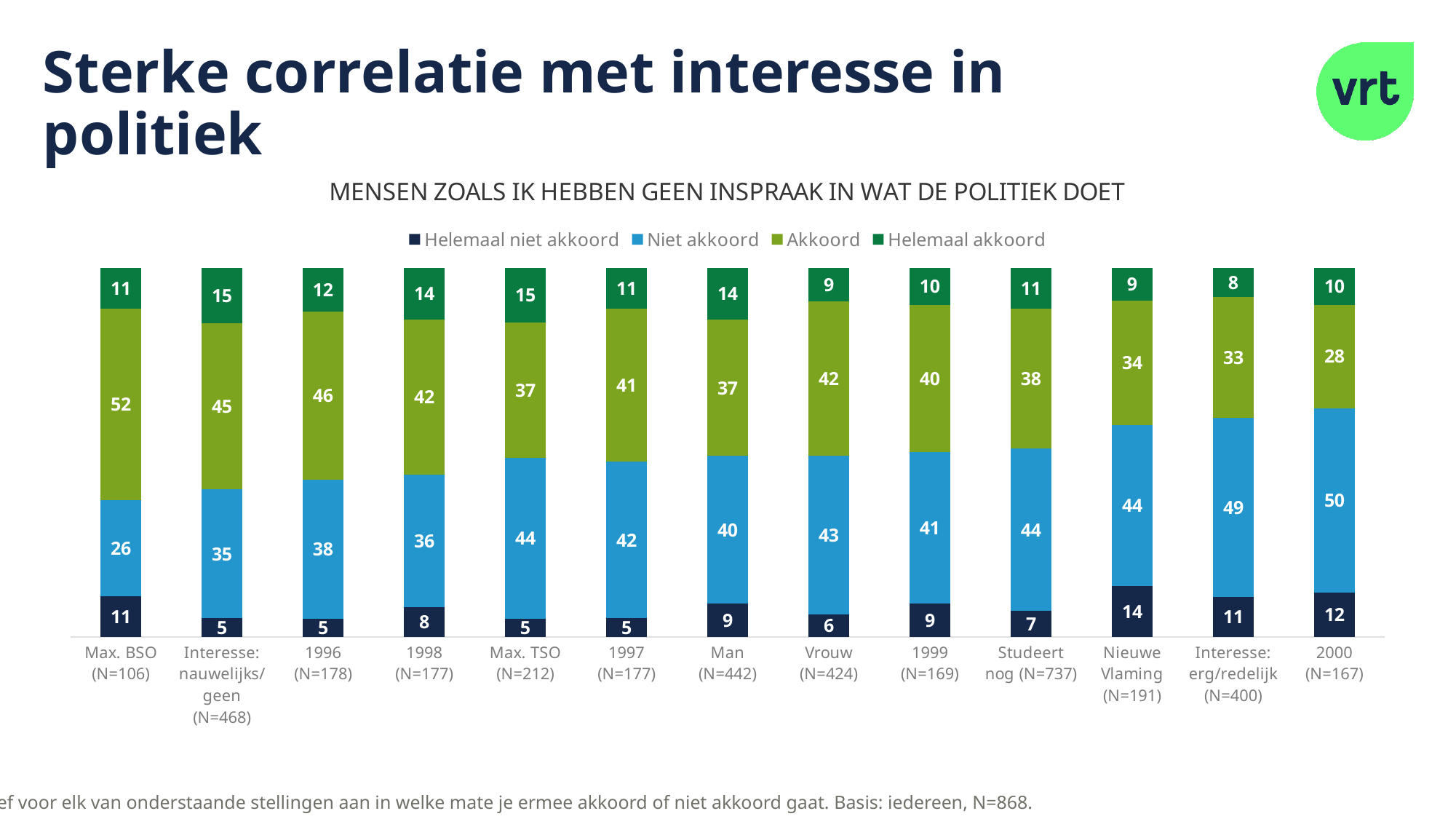
What is the difference between the 'Niet akkoord' values for Interesse: erg/redelijk (N=400) and Interesse: nauwelijks/geen (N=468)? 14 Which is larger: the 'Helemaal akkoord' value for Max. TSO (N=212) or for Vrouw (N=424)? Max. TSO (N=212) What is the total of the stacked bar for Man (N=442)? 100 What is the 'Niet akkoord' value for 2000 (N=167)? 50 How many categories are shown along the x axis? 13 Which category has the lowest 'Akkoord' value? 2000 (N=167) What kind of chart is shown on the slide? Stacked bar chart What is the 'Akkoord' value for Max. BSO (N=106)? 52 Which category has the highest 'Akkoord' value? Max. BSO (N=106) What is the 'Helemaal akkoord' value for Interesse: erg/redelijk (N=400)? 8 How many series does the legend list? 4 Which category has the highest 'Helemaal niet akkoord' value? Nieuwe Vlaming (N=191)